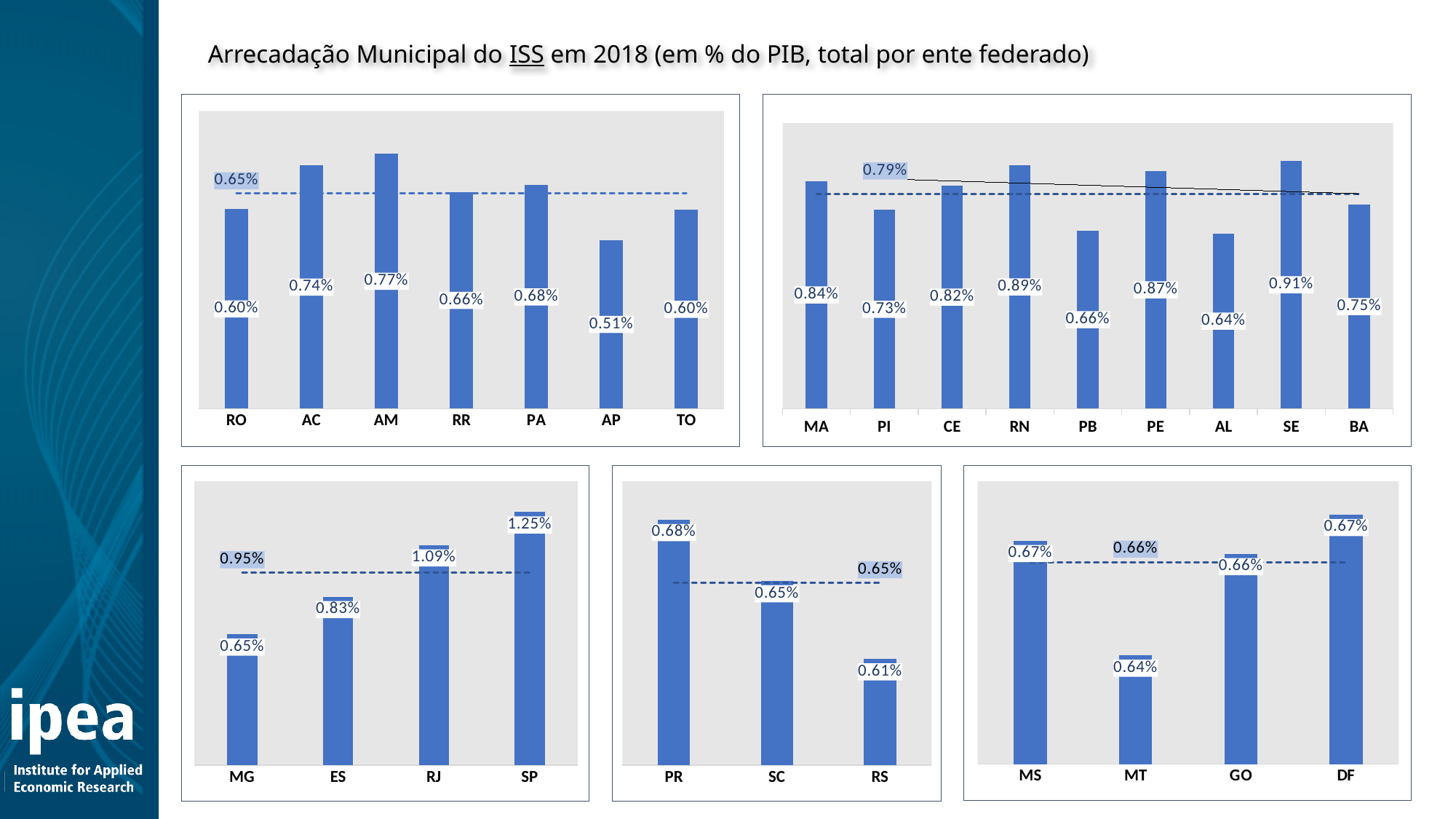
In the top-right chart (MA to BA), what is the difference between the values for RN and AL? 0.25% In the top-left chart (RO to TO), what is the value for AM? 0.77% In the top-right chart (MA to BA), which state has the highest value? SE In the bottom-middle chart (PR, SC, RS), which is larger, the value for PR or the value for RS? PR What kind of chart is used on this slide? bar chart In the top-right chart (MA to BA), how many states are shown? 9 In the top-left chart (RO to TO), which state has the lowest value? AP In the bottom-middle chart (PR, SC, RS), how many states are shown? 3 In the bottom-left chart (MG to SP), do the values rise or fall from MG to SP? rise In the bottom-left chart (MG to SP), what is the value for SP? 1.25% In the bottom-right chart (MS to DF), what is the value for MT? 0.64% In the top-right chart (MA to BA), what is the value for PB? 0.66%